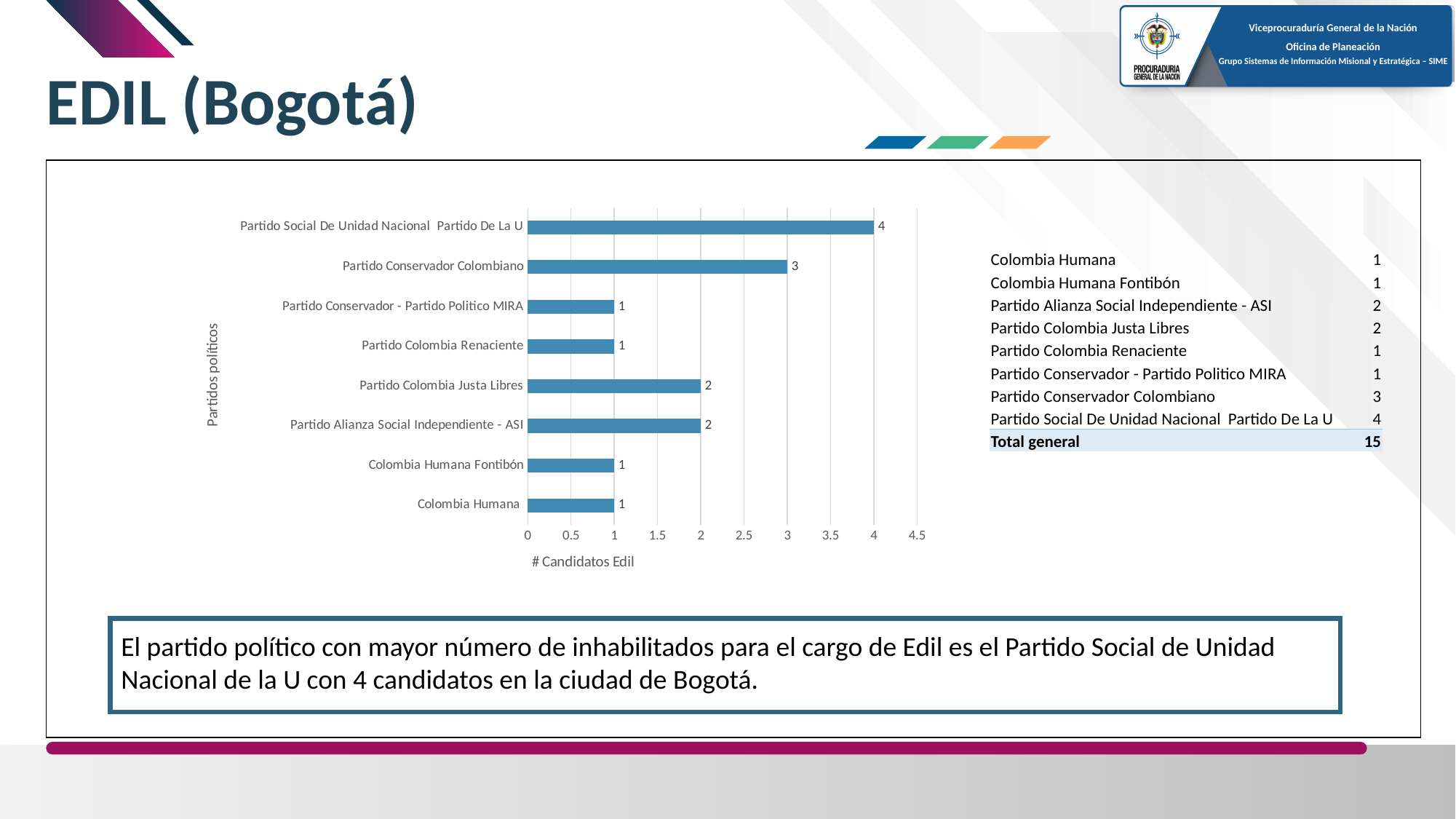
What is the value for Colombia Humana Fontibón? 1 What is the label of the vertical axis of the chart? Partidos políticos How many parties are shown in the chart? 8 What kind of chart is shown on the slide? bar chart What is the difference between the values for Partido Social De Unidad Nacional Partido De La U and Partido Conservador Colombiano? 1 What is the value for Partido Conservador Colombiano? 3 What is the value for Partido Colombia Justa Libres? 2 Which party has the highest number of Edil candidates? Partido Social De Unidad Nacional Partido De La U What is the total of all values shown in the chart? 15 Which is larger, the value for Partido Alianza Social Independiente - ASI or the value for Partido Colombia Renaciente? Partido Alianza Social Independiente - ASI What is the label of the horizontal axis of the chart? # Candidatos Edil Is the value for Partido Social De Unidad Nacional Partido De La U greater or less than 3.5? greater